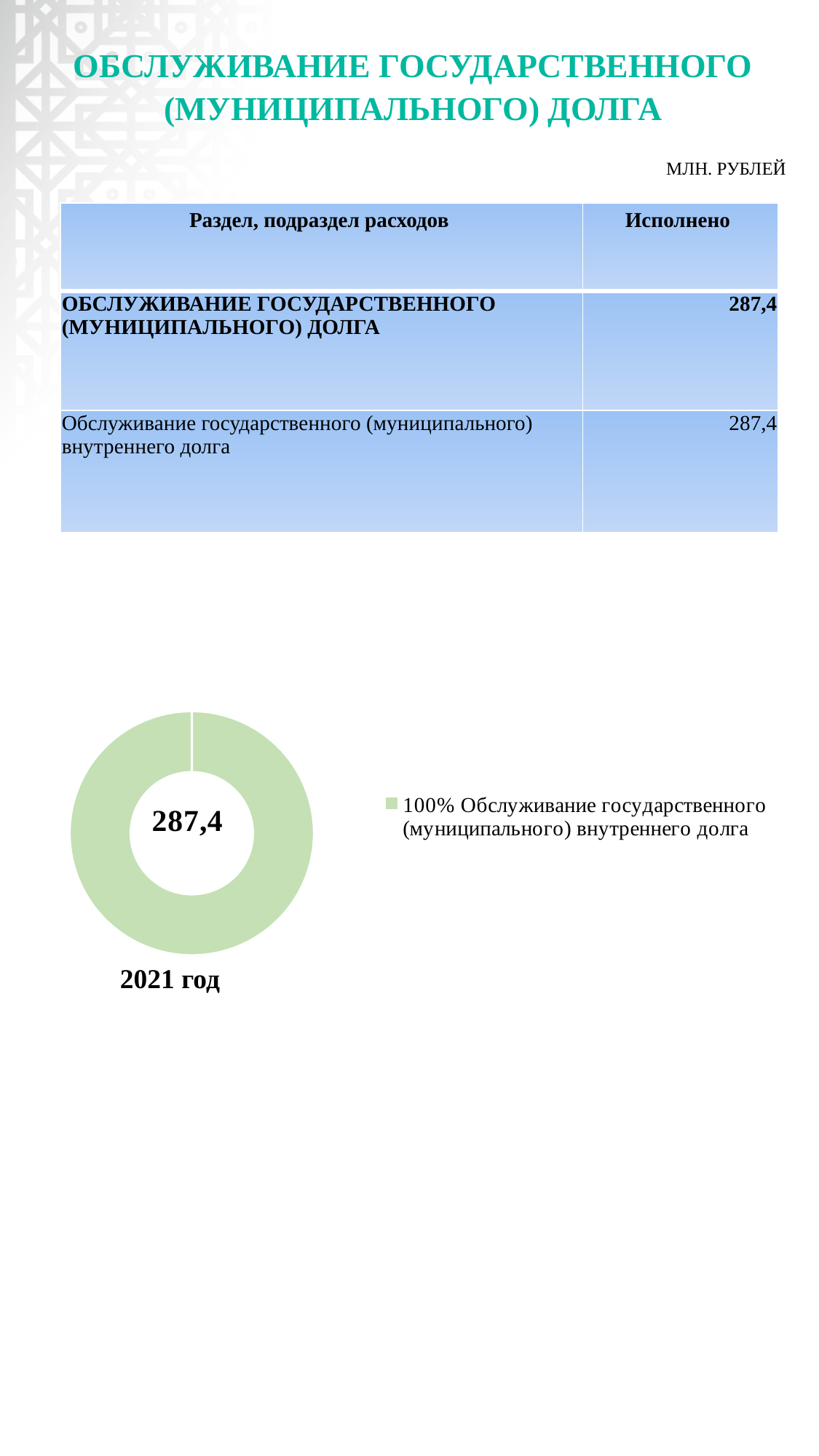
What colour is the single slice of the doughnut chart? green How many entries does the legend of the doughnut chart list? 1 How many slices does the doughnut chart have? 1 Is the value shown in the centre of the doughnut chart greater or less than 200? greater What share of the doughnut chart does "Обслуживание государственного (муниципального) внутреннего долга" take? 100% What value is printed in the centre of the doughnut chart? 287,4 Which year is labelled under the doughnut chart? 2021 год What kind of chart is shown on the slide? doughnut chart